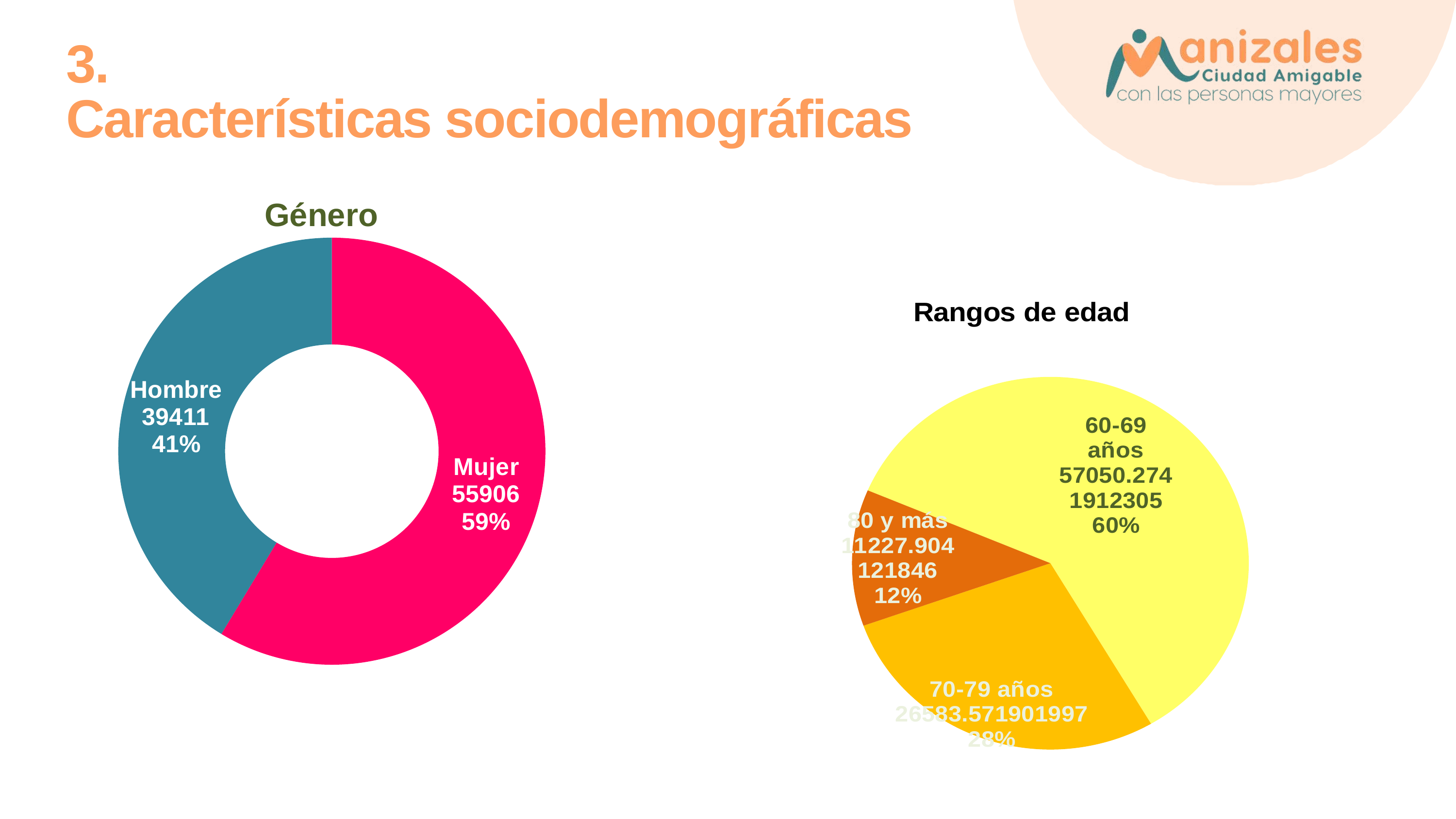
In the Rangos de edad chart, what percentage share does the 80 y más slice have? 12% What kind of chart is the Género chart? Donut chart In the Rangos de edad chart, which age range has the largest share? 60-69 años In the Género chart, what is the value for Hombre? 39411 In the Género chart, what is the total of the Hombre and Mujer values? 95317 In the Género chart, which category is larger, Hombre or Mujer? Mujer In the Género chart, what is the value for Mujer? 55906 In the Género chart, what percentage share does Mujer have? 59% How many slices does the Rangos de edad chart have? 3 In the Rangos de edad chart, what percentage share does the 60-69 años slice have? 60% In the Género chart, what is the difference between the Mujer and Hombre values? 16495